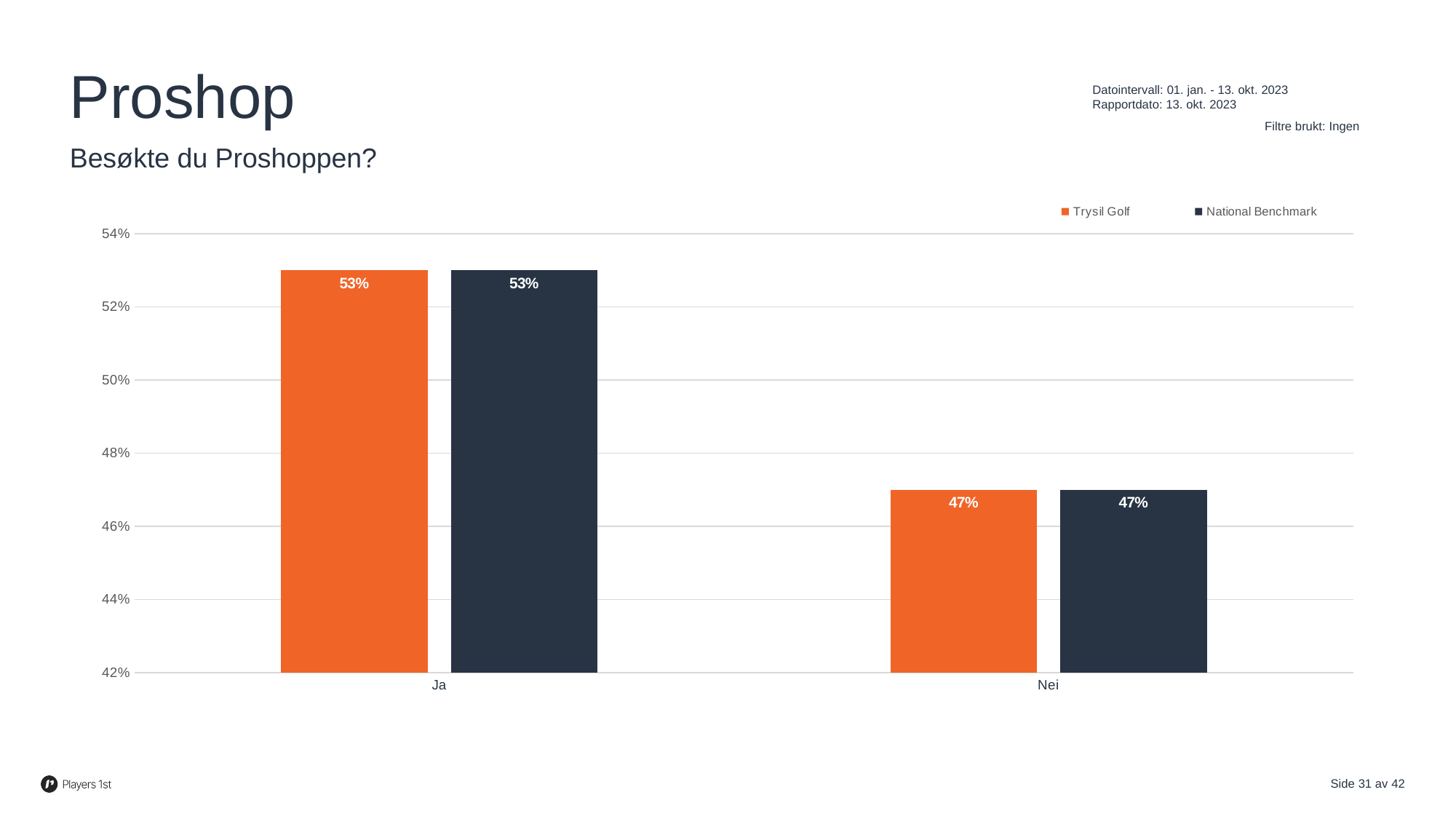
Which is larger for Trysil Golf: Ja or Nei? Ja What is the value for Trysil Golf in the Nei category? 47% Which category has the highest value for Trysil Golf? Ja What is the value for National Benchmark in the Ja category? 53% What kind of chart is shown on the slide? bar chart What is the value for National Benchmark in the Nei category? 47% Is the value for Trysil Golf in the Nei category greater or less than 50%? less How many series does the legend list? 2 What is the difference between the Trysil Golf values for Ja and Nei? 6% How many categories are shown on the x axis? 2 Which category has the lowest value for National Benchmark? Nei What is the value for Trysil Golf in the Ja category? 53%